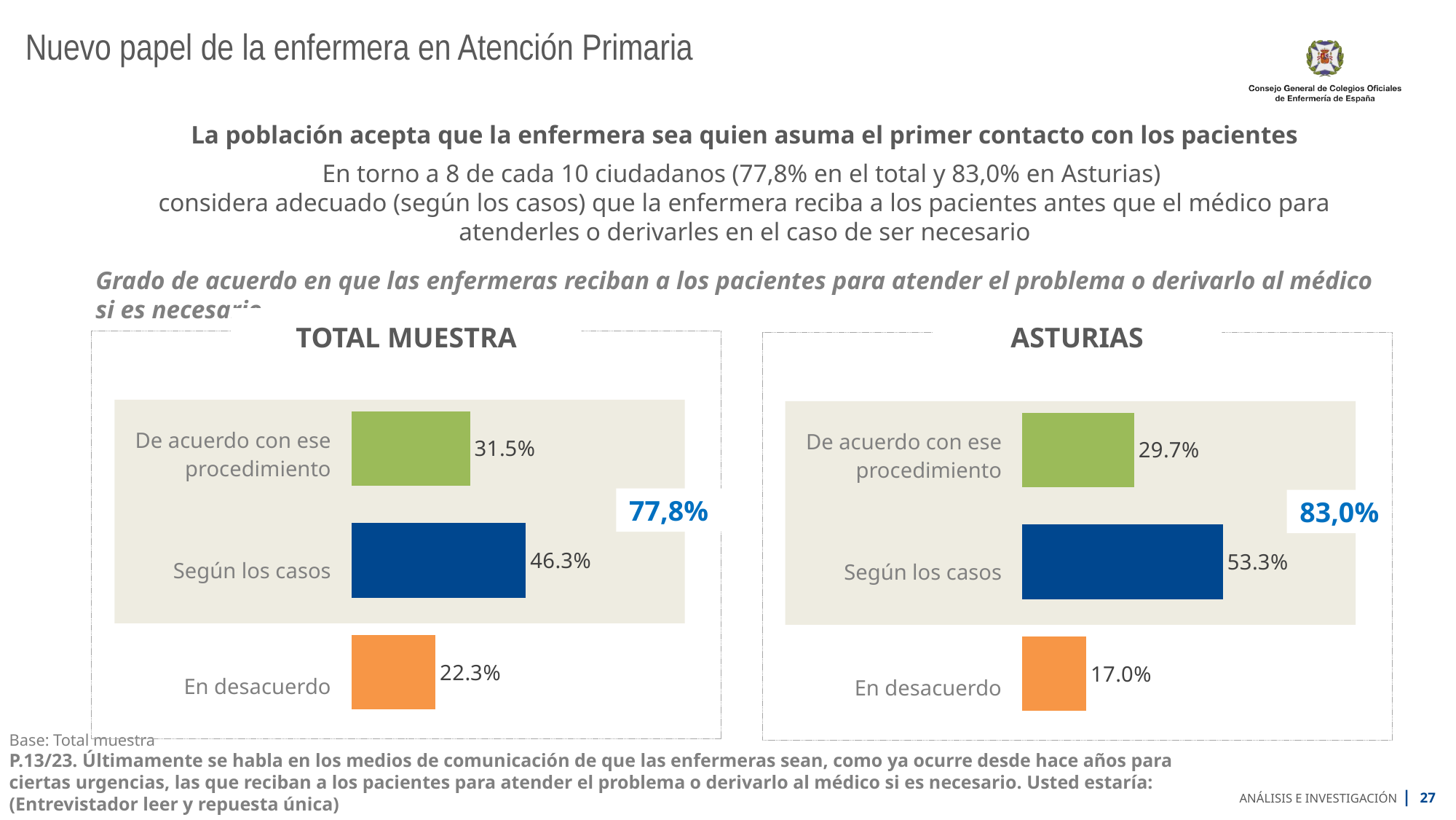
What kind of chart is the ASTURIAS chart? Bar chart Is the value for 'Según los casos' larger in the TOTAL MUESTRA chart or in the ASTURIAS chart? ASTURIAS In the TOTAL MUESTRA chart, which category has the lowest value? En desacuerdo What colour is the 'En desacuerdo' bar in the TOTAL MUESTRA chart? Orange How many categories does the TOTAL MUESTRA chart show? 3 In the TOTAL MUESTRA chart, what combined percentage is highlighted for the first two categories? 77,8% In the TOTAL MUESTRA chart, what is the value for 'Según los casos'? 46.3% In the TOTAL MUESTRA chart, what is the value for 'De acuerdo con ese procedimiento'? 31.5% In the ASTURIAS chart, what is the value for 'En desacuerdo'? 17.0% In the ASTURIAS chart, which category has the highest value? Según los casos In the ASTURIAS chart, what is the difference between 'Según los casos' and 'De acuerdo con ese procedimiento'? 23.6% In the ASTURIAS chart, what combined percentage is highlighted for the first two categories? 83,0%